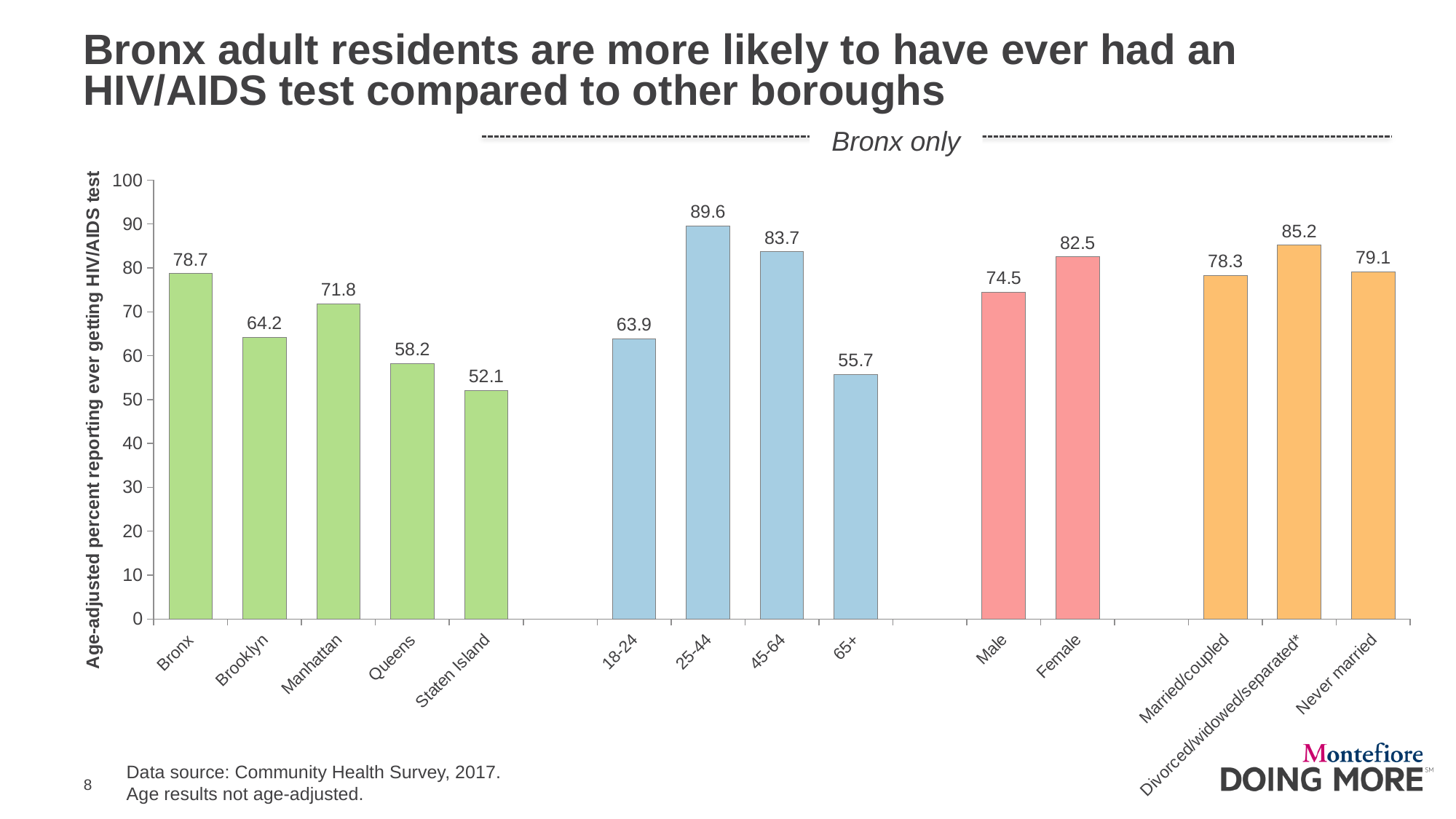
What is the value for Staten Island? 52.1 Which age group has the lowest value? 65+ What is the difference between the values for Bronx and Brooklyn? 14.5 What is the label of the vertical axis? Age-adjusted percent reporting ever getting HIV/AIDS test How many bars are plotted on the chart? 14 What is the value for Bronx? 78.7 What kind of chart is shown on the slide? Bar chart What is the value for Female? 82.5 Which borough has the highest value? Bronx Which is larger, the value for Married/coupled or the value for Never married? Never married What is the value for the 25-44 age group? 89.6 What is the difference between the values for Female and Male? 8.0